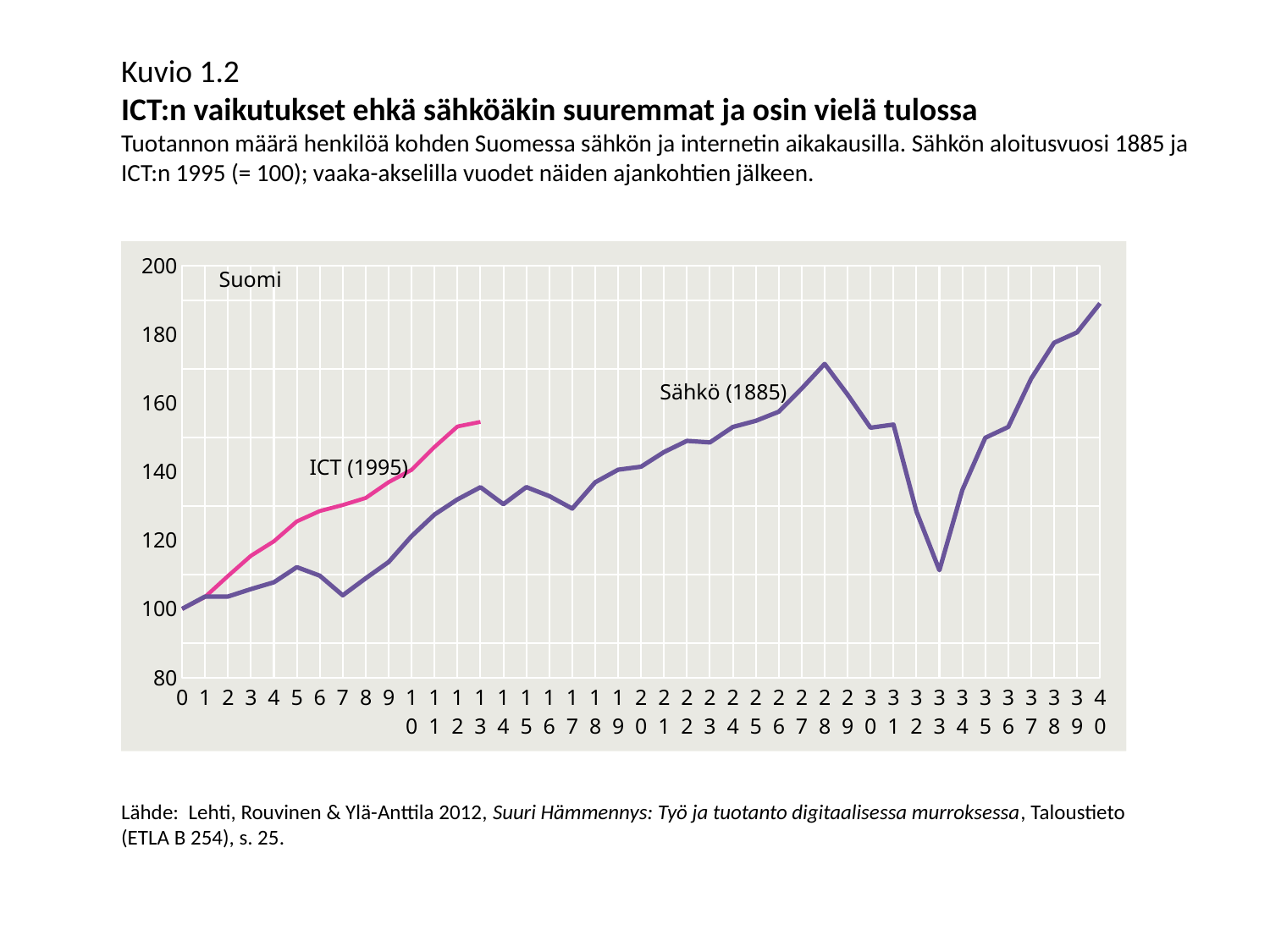
Is the value of the ICT (1995) series at year 13 greater or less than 140? greater What is the value of the Sähkö (1885) series at year 0? 100 What are the names of the two series plotted on the chart? Sähkö (1885) and ICT (1995) At year 10, which series has the higher value, ICT (1995) or Sähkö (1885)? ICT (1995) What colour is the ICT (1995) line? pink At which year on the x axis does the Sähkö (1885) series reach its highest value? 40 What kind of chart is shown on the slide? line chart At which year on the x axis is the Sähkö (1885) series at its lowest value? 0 How many series are plotted on the chart? 2 Is the value of the Sähkö (1885) series at year 33 greater or less than 120? less Does the Sähkö (1885) series rise or fall between year 28 and year 33? fall Is the value of the Sähkö (1885) series at year 28 greater or less than 160? greater